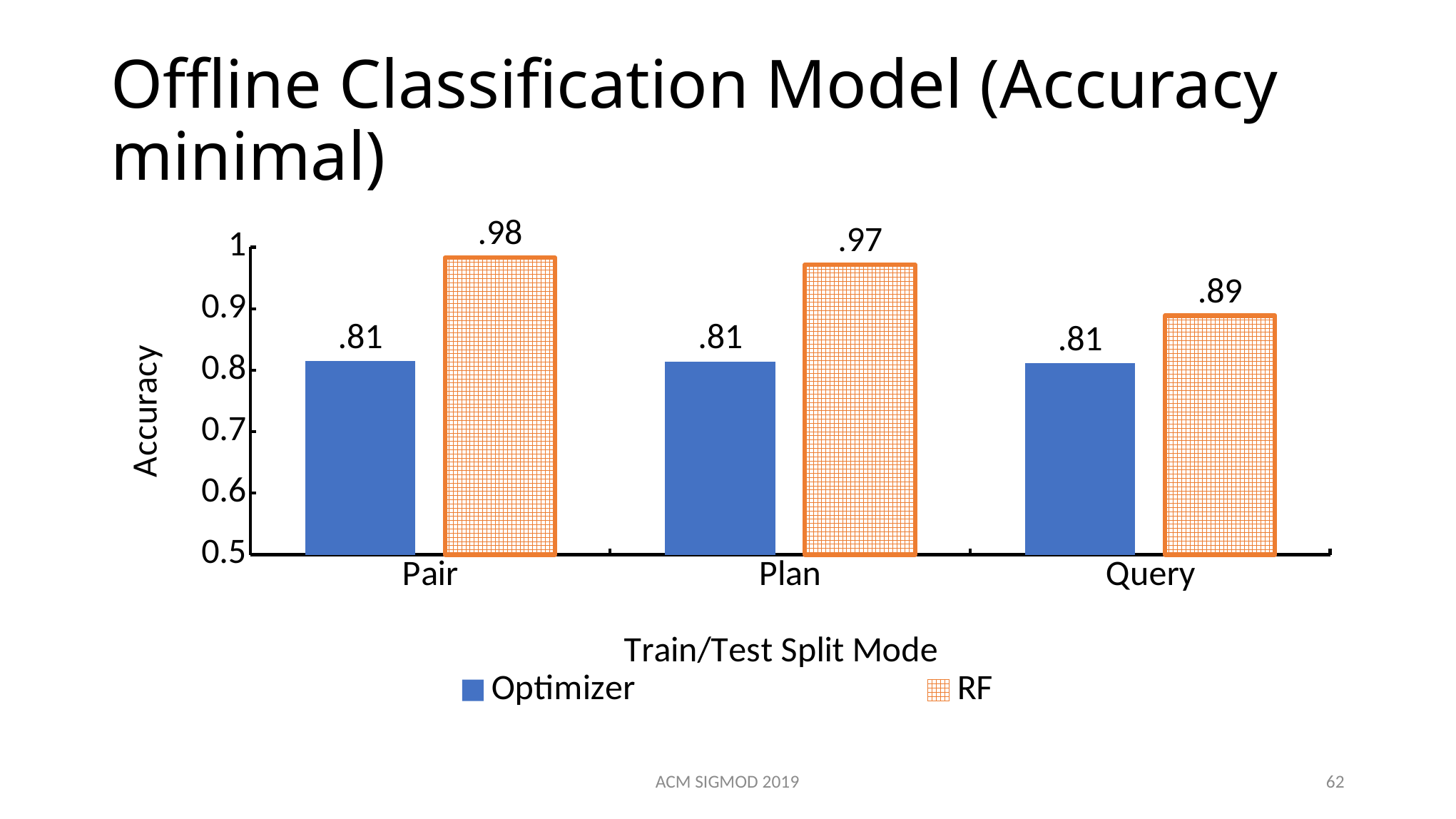
What is the accuracy of RF for the Pair split mode? .98 Which split mode has the lowest RF accuracy? Query How many split modes are shown on the x axis? 3 What is the difference between the RF and Optimizer accuracy for the Query split mode? .08 What is the accuracy of RF for the Plan split mode? .97 How many series does the legend list? 2 Is the RF accuracy for Query greater or less than 0.9? less What kind of chart is shown on the slide? bar chart For the Plan split mode, which series has the higher accuracy, Optimizer or RF? RF What is the difference between the RF accuracy for Pair and the RF accuracy for Query? .09 Which split mode has the highest RF accuracy? Pair What is the accuracy of Optimizer for the Query split mode? .81